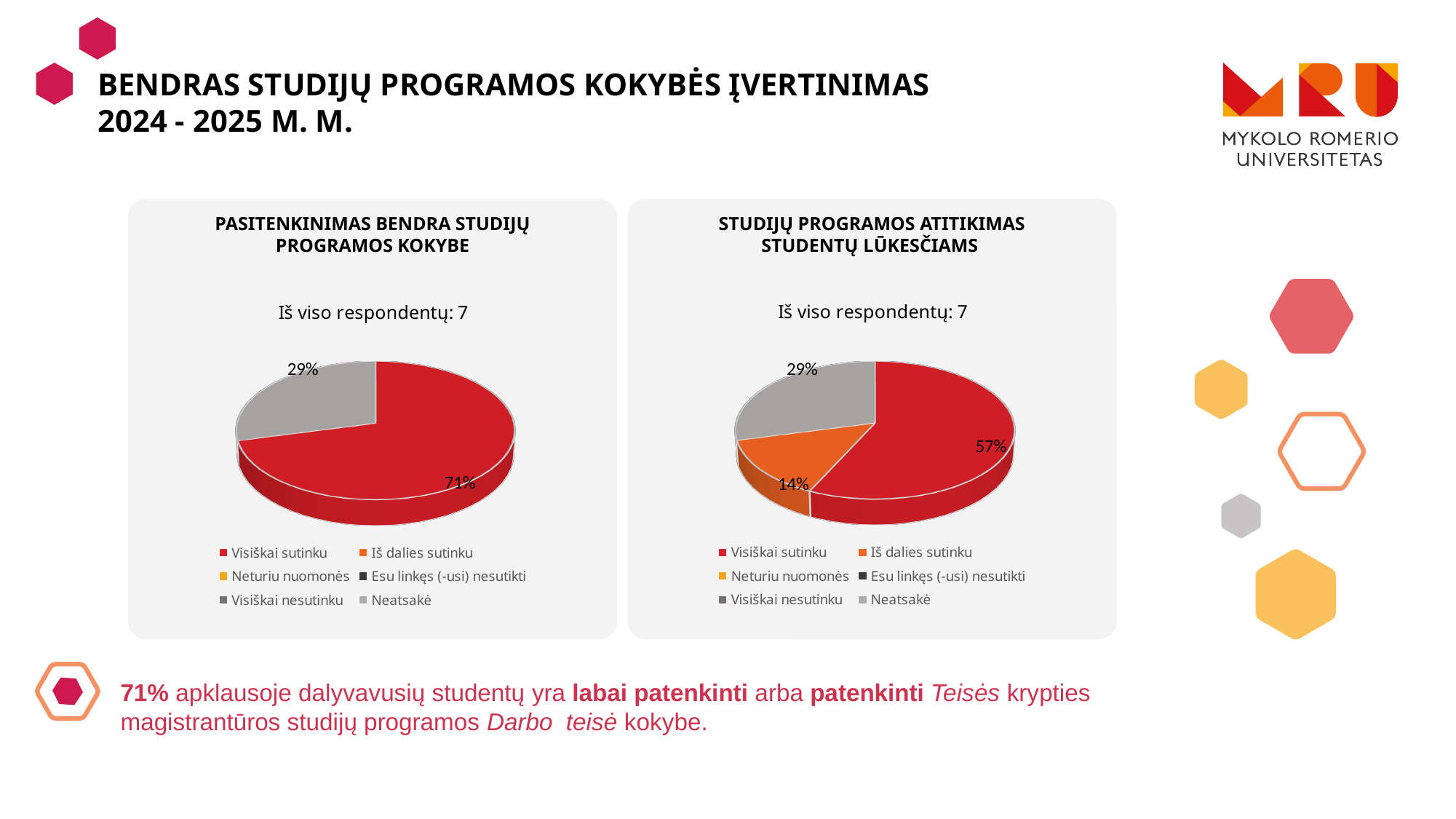
Which chart has the larger 'Visiškai sutinku' share, the left one or the right one? The left one In the right chart (Studijų programos atitikimas studentų lūkesčiams), what share of respondents answered 'Iš dalies sutinku'? 14% In the right chart (Studijų programos atitikimas studentų lūkesčiams), which response category has the smallest slice? Iš dalies sutinku How many slices are shown in the right chart (Studijų programos atitikimas studentų lūkesčiams)? 3 In the right chart (Studijų programos atitikimas studentų lūkesčiams), what share of respondents answered 'Visiškai sutinku'? 57% In the right chart (Studijų programos atitikimas studentų lūkesčiams), what is the difference in percentage points between the 'Visiškai sutinku' and 'Neatsakė' slices? 28 How many entries does the legend of the left chart list? 6 What type of chart is used on this slide? Pie chart In the right chart (Studijų programos atitikimas studentų lūkesčiams), which response category has the largest slice? Visiškai sutinku In the left chart (Pasitenkinimas bendra studijų programos kokybe), what share is labelled for the grey 'Neatsakė' slice? 29% In the right chart (Studijų programos atitikimas studentų lūkesčiams), what share is labelled for the 'Neatsakė' slice? 29% In the left chart (Pasitenkinimas bendra studijų programos kokybe), what share of respondents answered 'Visiškai sutinku'? 71%